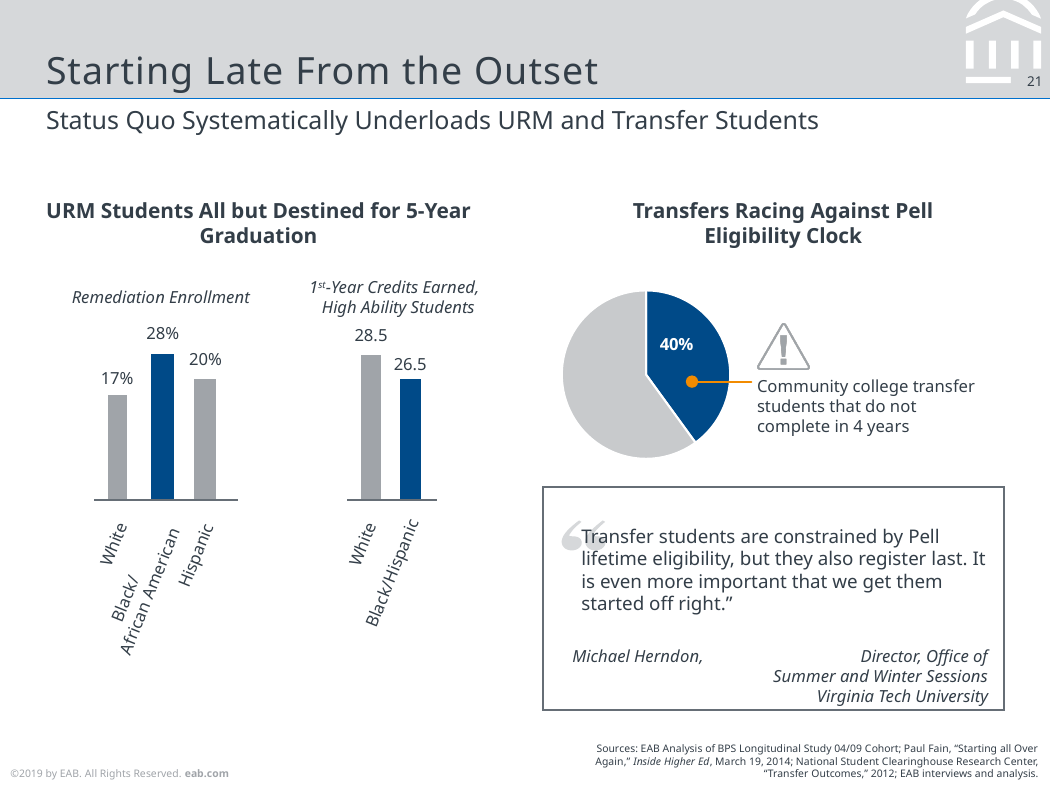
In the Remediation Enrollment chart, what is the value for Black/African American students? 28% In the Remediation Enrollment chart, how many categories are shown? 3 What kind of chart is the Remediation Enrollment chart? Bar chart In the 1st-Year Credits Earned, High Ability Students chart, what is the value for Black/Hispanic students? 26.5 In the Remediation Enrollment chart, what is the value for White students? 17% In the Remediation Enrollment chart, which category has the lowest value? White In the pie chart under Transfers Racing Against Pell Eligibility Clock, what share of community college transfer students do not complete in 4 years? 40% In the 1st-Year Credits Earned, High Ability Students chart, what is the difference between the White and Black/Hispanic values? 2 In the Remediation Enrollment chart, what is the difference between the Black/African American and Hispanic values? 8% What kind of chart is shown under the title Transfers Racing Against Pell Eligibility Clock? Pie chart In the Remediation Enrollment chart, which category has the highest value? Black/African American In the 1st-Year Credits Earned, High Ability Students chart, which is larger, the value for White or for Black/Hispanic? White